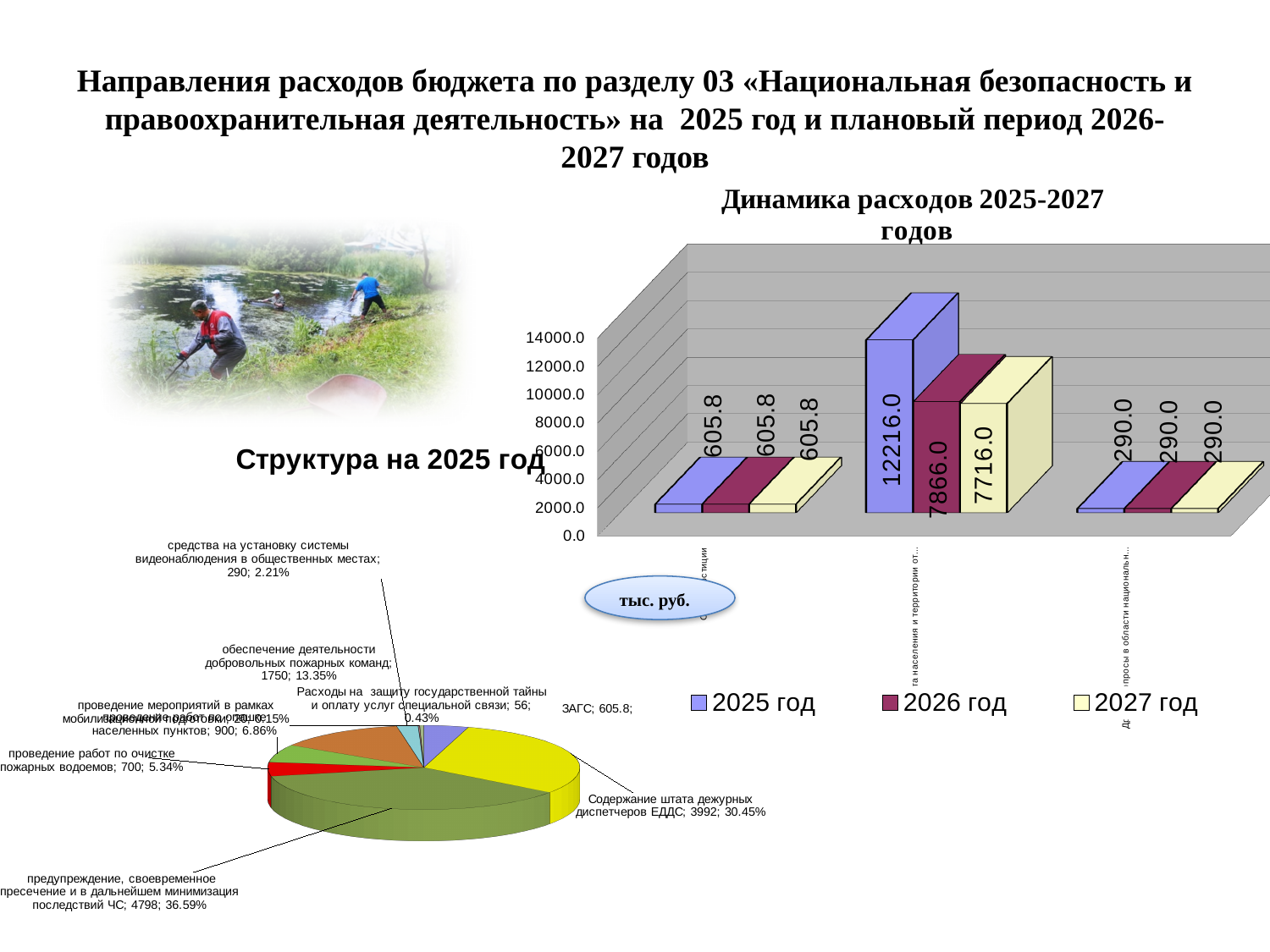
In the chart 'Динамика расходов 2025-2027 годов', how many series does the legend list? 3 In the chart 'Структура на 2025 год', which is larger: 'обеспечение деятельности добровольных пожарных команд' or 'проведение работ по очистке пожарных водоемов'? обеспечение деятельности добровольных пожарных команд In the chart 'Структура на 2025 год', what is the value for 'Содержание штата дежурных диспетчеров ЕДДС'? 3992 In the chart 'Динамика расходов 2025-2027 годов', what is the value for 2027 год in the leftmost group of bars? 605.8 In the chart 'Динамика расходов 2025-2027 годов', what is the difference between the 2025 год and 2026 год values in the middle group of bars? 4350.0 In the chart 'Динамика расходов 2025-2027 годов', what is the value for 2025 год in the middle group of bars? 12216.0 In the chart 'Структура на 2025 год', what share of the pie is 'предупреждение, своевременное пресечение и в дальнейшем минимизация последствий ЧС'? 36.59% In the chart 'Динамика расходов 2025-2027 годов', what is the value for 2026 год in the middle group of bars? 7866.0 In the chart 'Динамика расходов 2025-2027 годов', what is the value for 2025 год in the rightmost group of bars? 290.0 In the chart 'Динамика расходов 2025-2027 годов', what is the value for 2027 год in the middle group of bars? 7716.0 What kind of chart is 'Динамика расходов 2025-2027 годов'? bar chart In the chart 'Структура на 2025 год', what is the value for 'Расходы на защиту государственной тайны и оплату услуг специальной связи'? 56